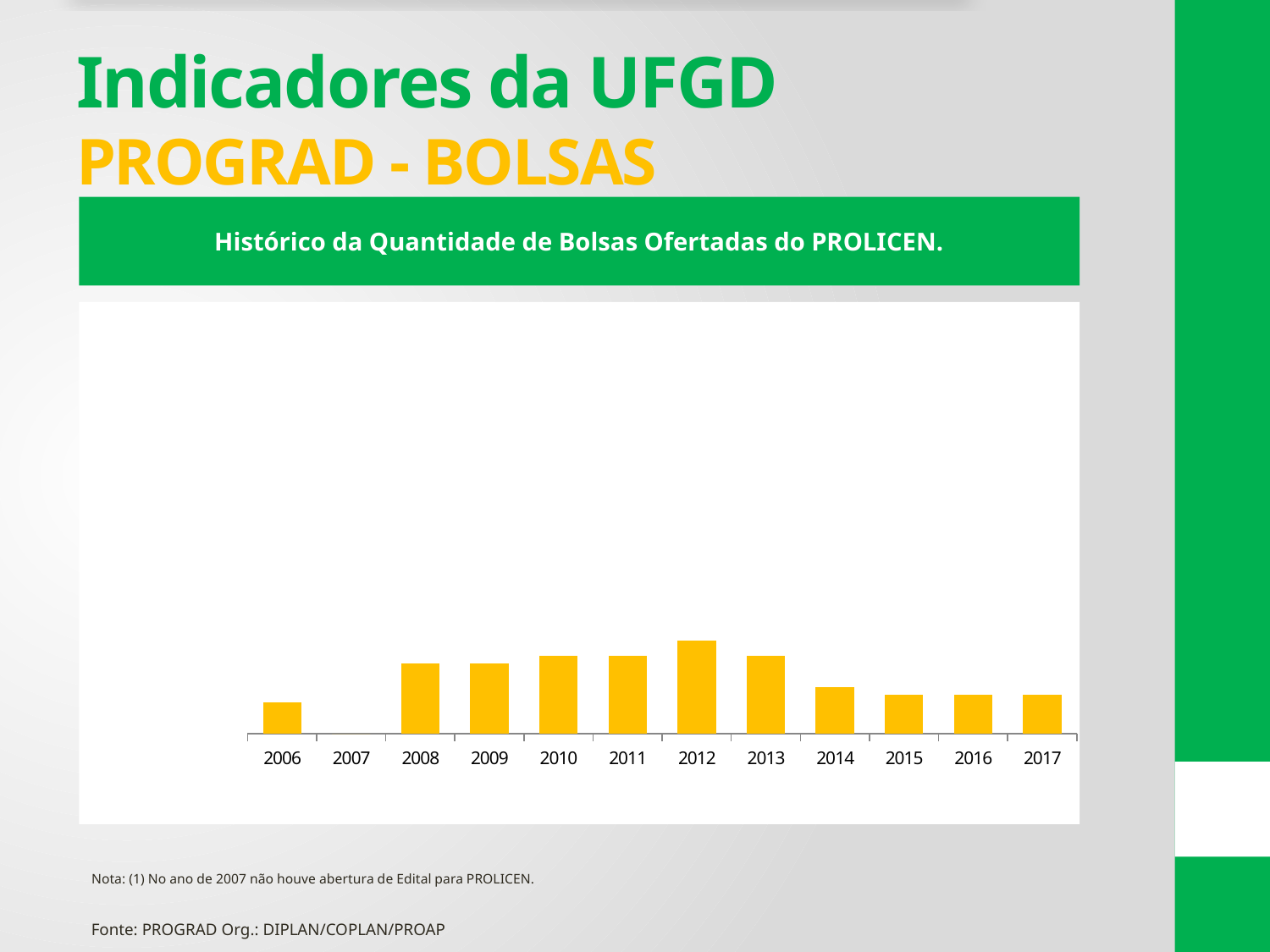
Which year on the x axis has no bar at all? 2007 Which year has the tallest bar in the chart? 2012 Which year has the taller bar, 2008 or 2006? 2008 Which year has the taller bar, 2012 or 2017? 2012 What colour are the bars in the chart? yellow What is the title of the chart? Histórico da Quantidade de Bolsas Ofertadas do PROLICEN. Do the bars rise or fall from 2008 to 2012? rise What kind of chart is shown on the slide? bar chart Among the years with a visible bar, which year has the shortest bar? 2006 Which year has the taller bar, 2013 or 2014? 2013 Do the bars rise or fall from 2012 to 2017? fall How many years are shown on the x axis of the chart? 12